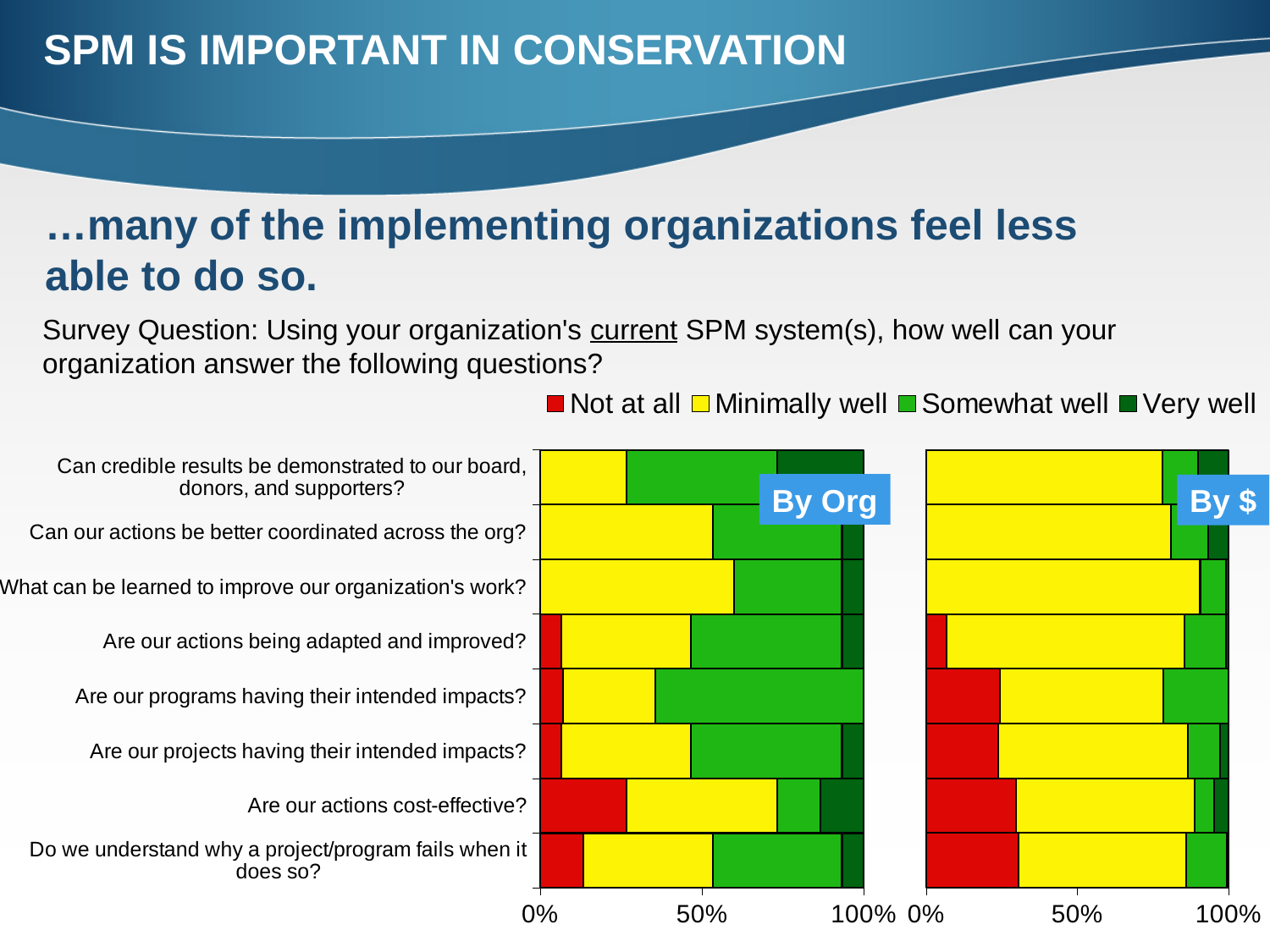
In the 'By $' chart, is the 'Minimally well' share for 'Can credible results be demonstrated to our board, donors, and supporters?' greater or less than 50%? greater How many series does the legend list? 4 What are the two labels that distinguish the left and right charts? By Org and By $ How many survey questions (categories) are plotted in the 'By Org' chart? 8 In the 'By Org' chart, how many survey questions have no 'Not at all' segment? 3 In the 'By Org' chart, is the 'Not at all' share for 'Are our actions cost-effective?' greater or less than 50%? less In the 'By $' chart, is the 'Not at all' share for 'Are our actions being adapted and improved?' greater or less than 50%? less What is the highest value shown on the x axis of each chart? 100% In the 'By Org' chart, which has the larger 'Not at all' share: 'Are our actions cost-effective?' or 'Are our programs having their intended impacts?' Are our actions cost-effective? In the 'By Org' chart, which survey question has the largest 'Not at all' share? Are our actions cost-effective? What kind of chart is the 'By Org' chart? Stacked bar chart Which colour represents 'Not at all' in the legend? Red